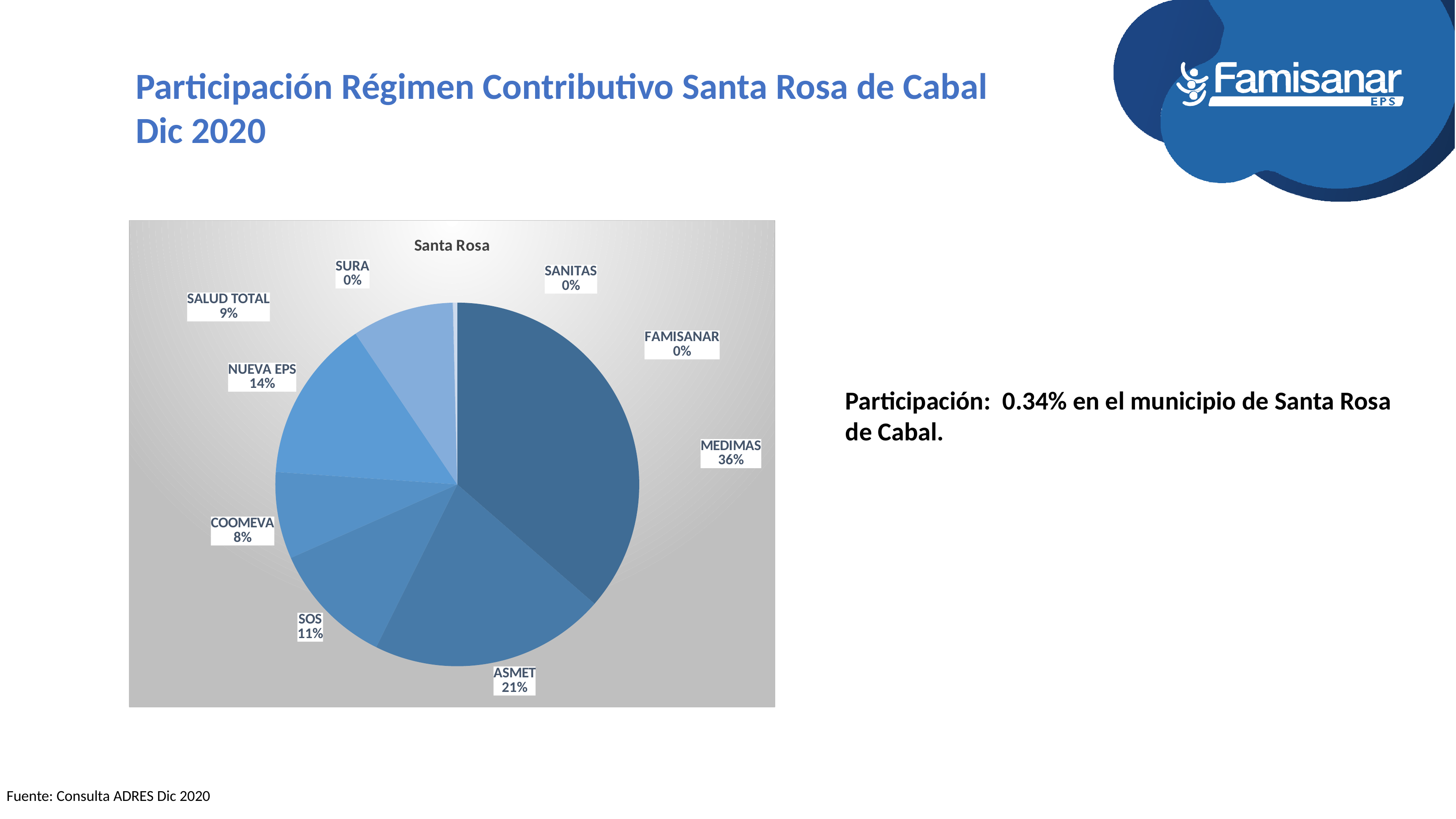
What is the title of the chart? Santa Rosa What share of the pie does MEDIMAS hold? 36% How many categories are labelled on the pie chart? 9 What is the value shown for SALUD TOTAL? 9% Which category has the largest share of the pie? MEDIMAS What is the value shown for SOS? 11% What is the value shown for ASMET? 21% Which is larger, the share for NUEVA EPS or the share for SOS? NUEVA EPS What is the difference between the shares of MEDIMAS and ASMET? 15% What is the value shown for COOMEVA? 8% What type of chart is shown on the slide? Pie chart What is the value shown for NUEVA EPS? 14%